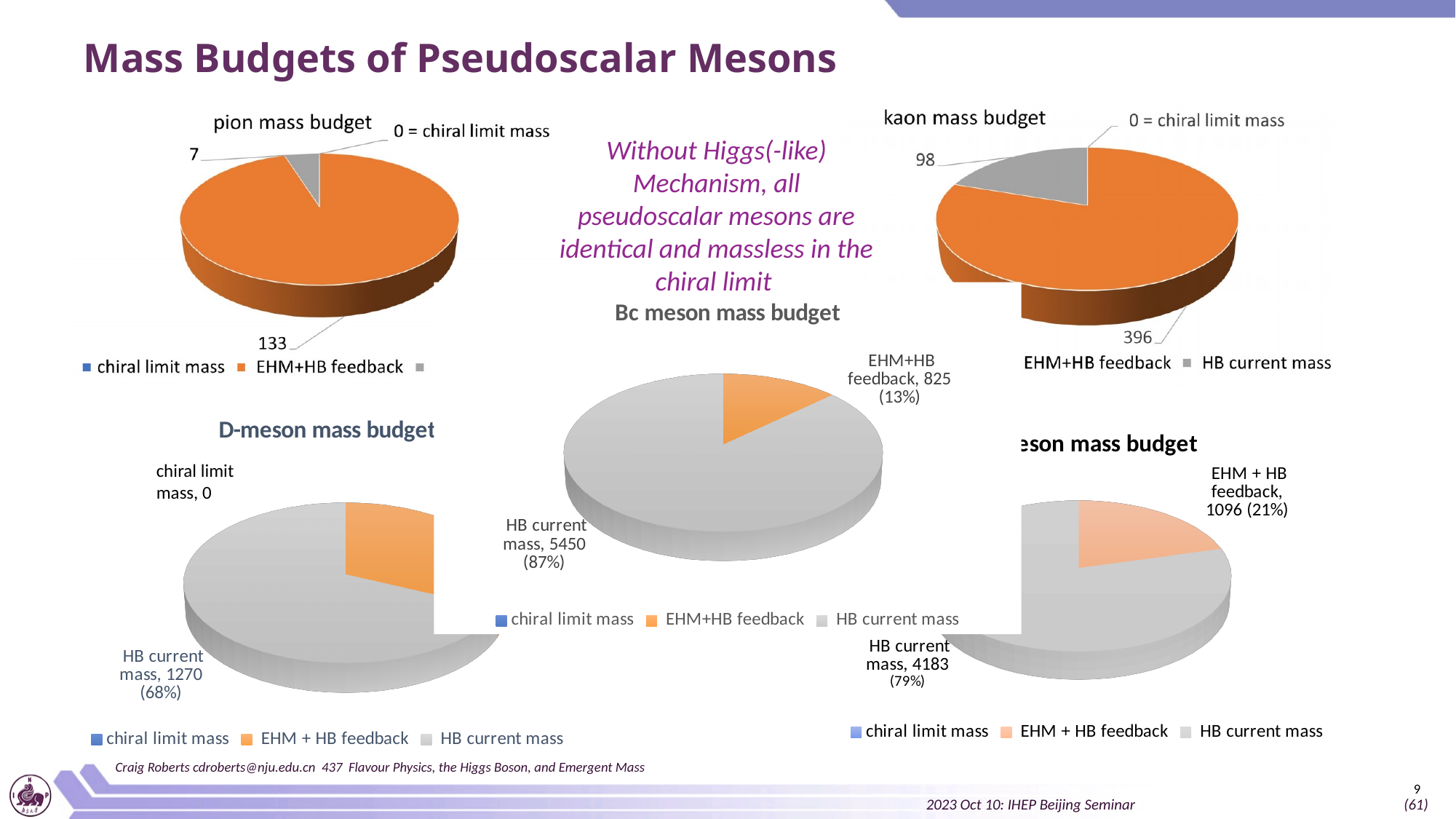
In the Bc meson mass budget chart, what is the value for HB current mass? 5450 In the Bc meson mass budget chart, what share of the pie is EHM+HB feedback? 13% In the kaon mass budget chart, what is the value for HB current mass? 98 In the bottom-right pie chart, what share of the pie is HB current mass? 79% What kind of chart is the kaon mass budget chart? pie chart In the kaon mass budget chart, what is the difference between EHM+HB feedback and HB current mass? 298 In the bottom-right pie chart, what is the value for EHM + HB feedback? 1096 In the pion mass budget chart, what is the value for EHM+HB feedback? 133 In the D-meson mass budget chart, what is the value for HB current mass? 1270 In the pion mass budget chart, what is the value for HB current mass? 7 In the D-meson mass budget chart, what share of the pie is HB current mass? 68% In the Bc meson mass budget chart, which is larger, HB current mass or EHM+HB feedback? HB current mass